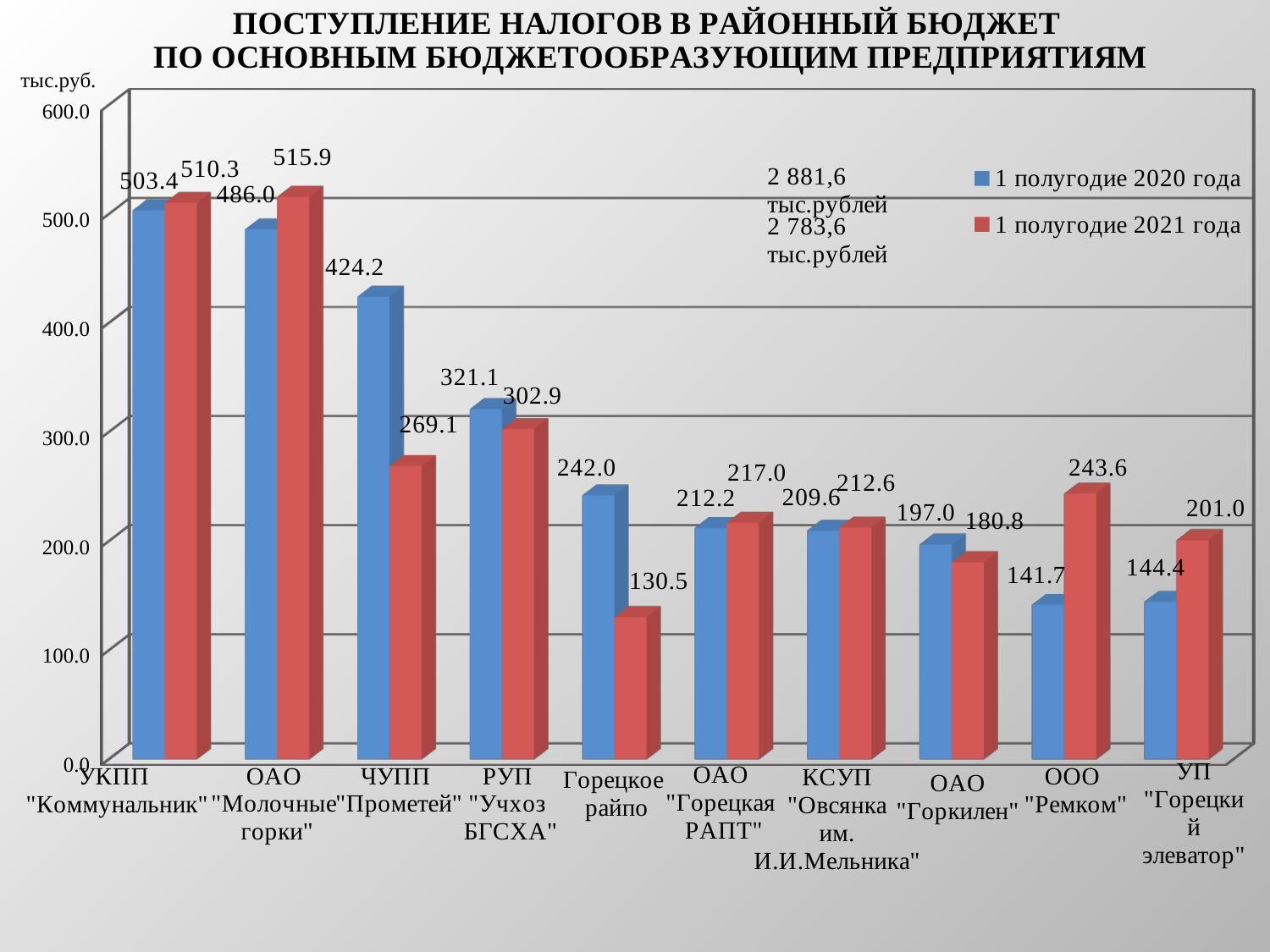
What kind of chart is shown on the slide? bar chart Which is larger for УП "Горецкий элеватор": the 1 полугодие 2020 года value or the 1 полугодие 2021 года value? 1 полугодие 2021 года Is the 1 полугодие 2020 года value for РУП "Учхоз БГСХА" greater or less than 300.0? greater How many series does the legend list? 2 What is the value for ООО "Ремком" in the 1 полугодие 2021 года series? 243.6 What unit is shown on the vertical axis of the chart? тыс.руб. What is the difference between the 1 полугодие 2020 года and 1 полугодие 2021 года values for ЧУПП "Прометей"? 155.1 What is the value for Горецкое райпо in the 1 полугодие 2021 года series? 130.5 What is the value for ЧУПП "Прометей" in the 1 полугодие 2020 года series? 424.2 Which category has the highest value in the 1 полугодие 2021 года series? ОАО "Молочные горки" How many categories (enterprises) are shown on the x axis? 10 Which category has the lowest value in the 1 полугодие 2020 года series? ООО "Ремком"